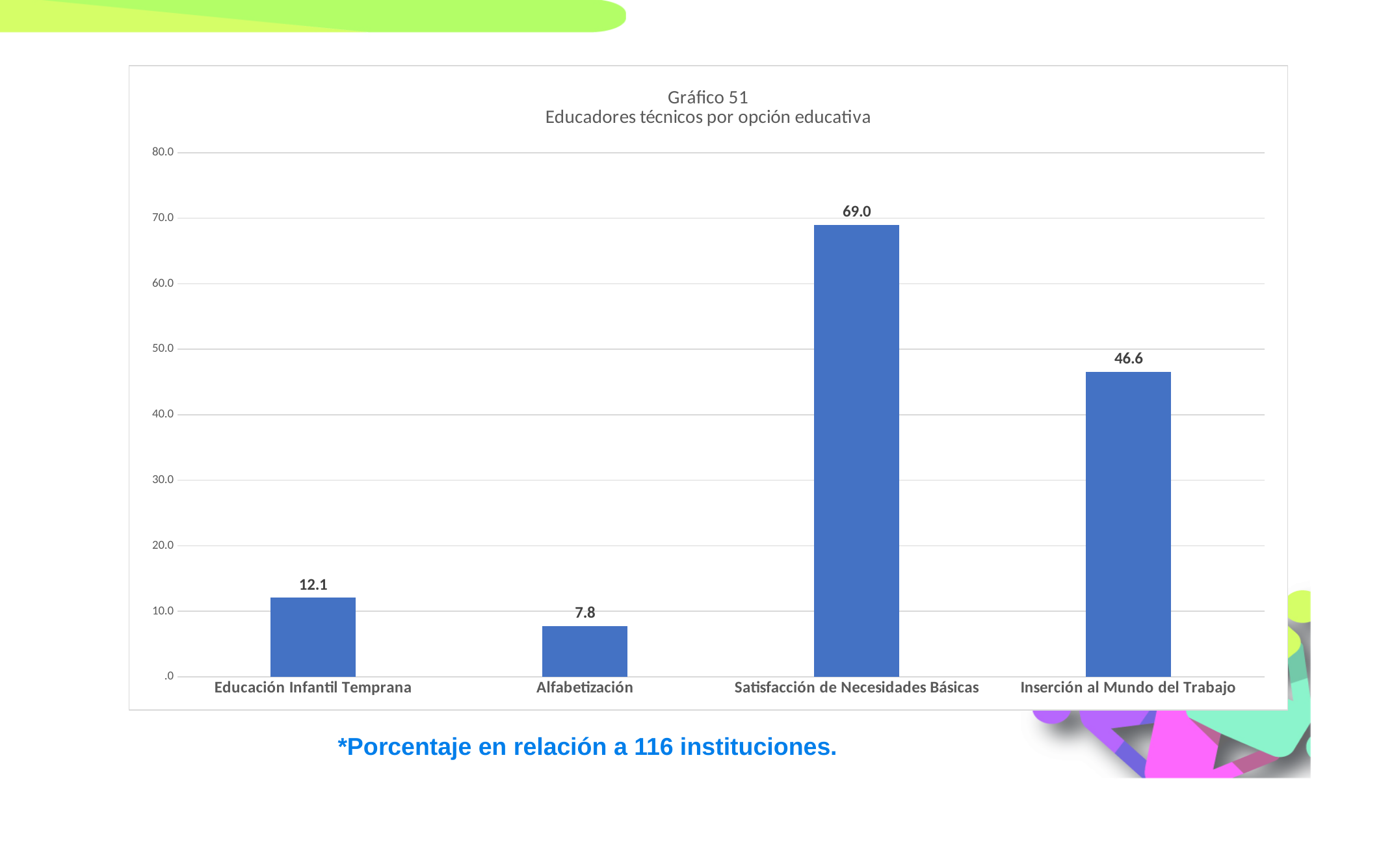
Which category has the highest value? Satisfacción de Necesidades Básicas What kind of chart is shown on the slide? bar chart What is the title of the chart? Gráfico 51 Educadores técnicos por opción educativa What is the value for Alfabetización? 7.8 What is the difference between the values for Satisfacción de Necesidades Básicas and Inserción al Mundo del Trabajo? 22.4 What is the value for Inserción al Mundo del Trabajo? 46.6 Is the value for Inserción al Mundo del Trabajo greater or less than 40.0? greater What is the value for Educación Infantil Temprana? 12.1 What is the value for Satisfacción de Necesidades Básicas? 69.0 How many categories are shown on the x axis? 4 Which is larger, the value for Educación Infantil Temprana or the value for Alfabetización? Educación Infantil Temprana Which category has the lowest value? Alfabetización